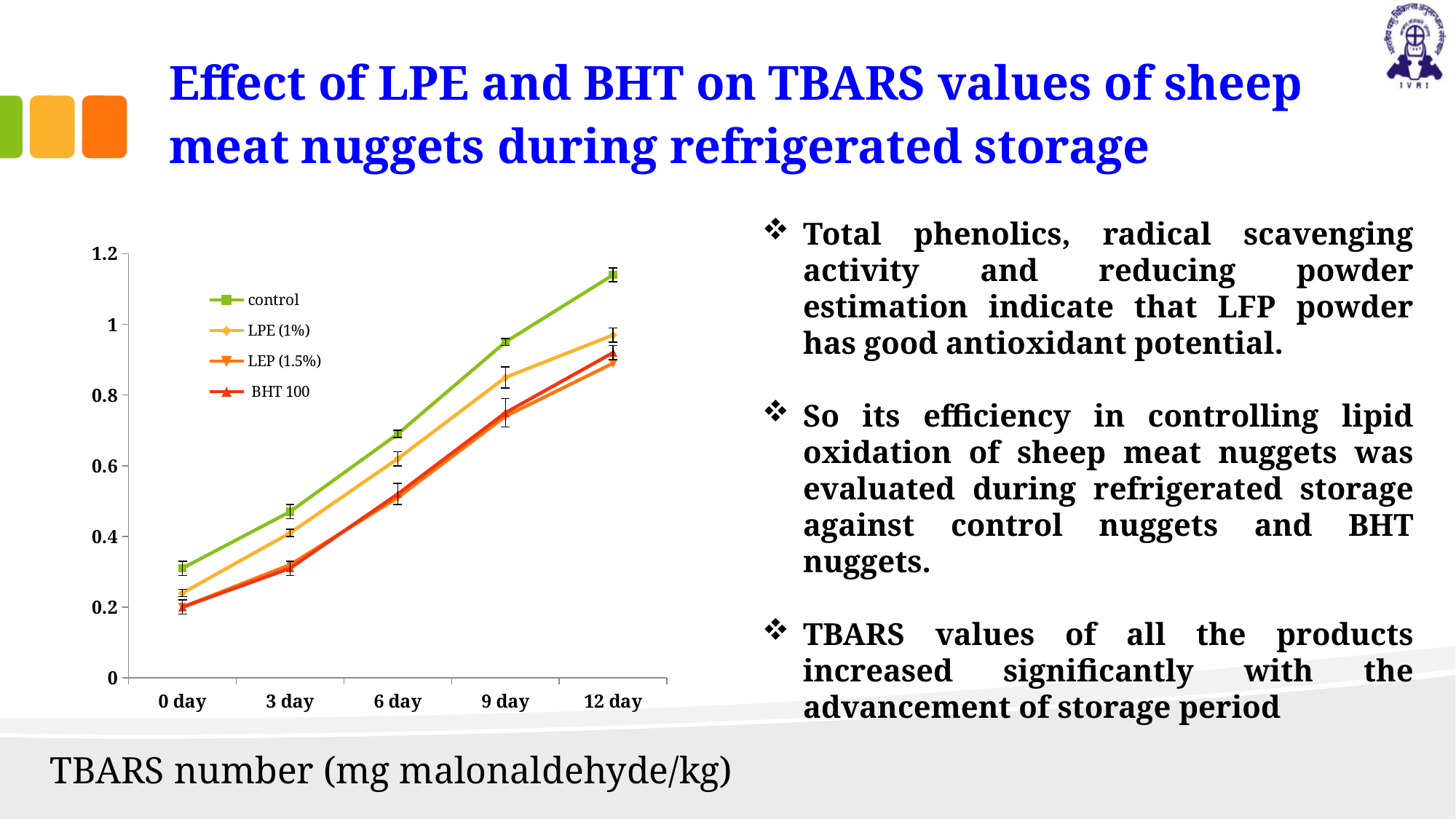
How many storage time points are plotted along the x axis? 5 At 9 day, which is larger: the control value or the LPE (1%) value? control What kind of chart is shown on the slide? line chart Is the BHT 100 value at 0 day greater or less than 0.4? less How many series does the chart legend list? 4 What is the label of the x-axis category furthest to the right? 12 day Which series has the highest TBARS value at 12 day? control Do the TBARS values for the control series rise or fall from 0 day to 12 day? rise Which series has the highest TBARS value at 6 day? control Is the control value at 12 day greater or less than 1? greater Is the control value at 9 day greater or less than 1? less